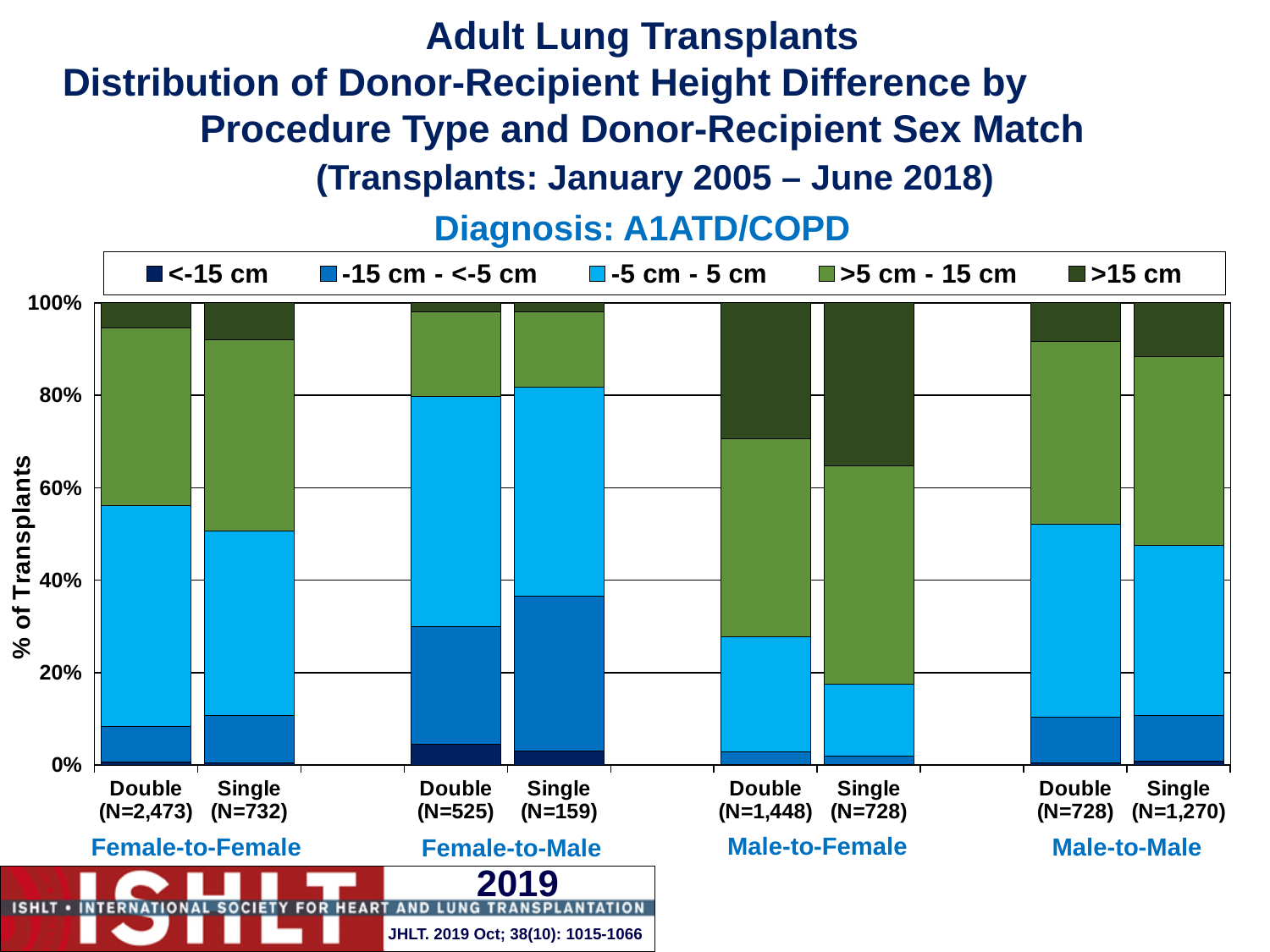
What is the N for the Female-to-Male Single bar? N=159 What diagnosis does the chart cover, as stated in the subtitle? A1ATD/COPD Which bar has the largest -15 cm - <-5 cm share? Female-to-Male Single Which bar has the larger >15 cm share: Male-to-Female Double or Female-to-Female Double? Male-to-Female Double How many bars are plotted in the chart? 8 What is the difference between the N for Female-to-Female Double and the N for Female-to-Female Single? 1,741 Is the >15 cm share of the Male-to-Female Double bar greater or less than 20%? greater What is the N for the Female-to-Female Double bar? N=2,473 Which bar has the smallest N shown in its label? Female-to-Male Single (N=159) Which bar has the largest N shown in its label? Female-to-Female Double (N=2,473) What kind of chart is shown on the slide? Stacked bar chart How many series does the legend list? 5